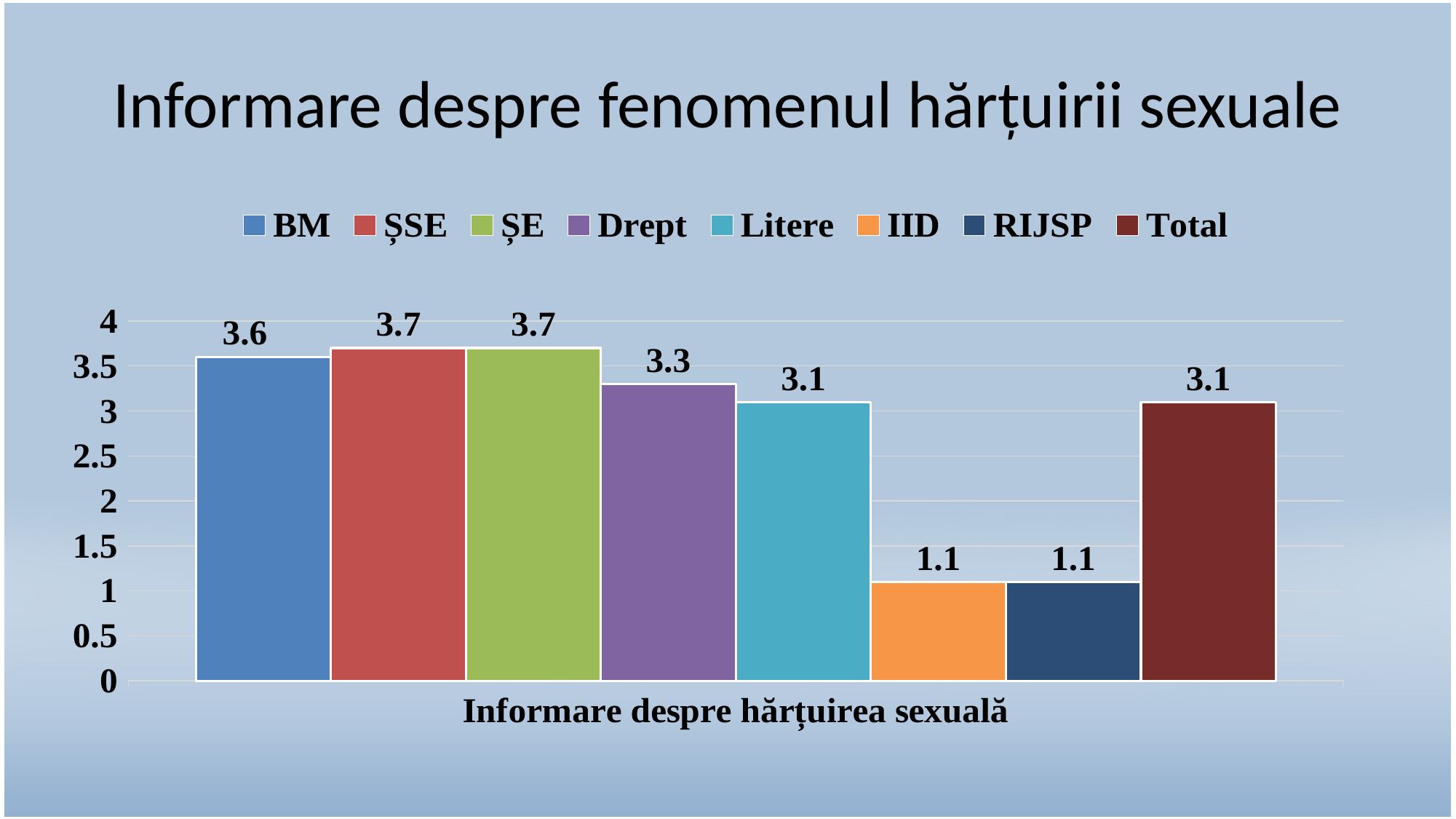
What is the value for Total? 3.1 What kind of chart is shown on the slide? bar chart What is the title of the slide? Informare despre fenomenul hărțuirii sexuale What is the value for BM? 3.6 What is the value for Litere? 3.1 What is the value for Drept? 3.3 What is the value for IID? 1.1 Which series has the lowest value, BM or RIJSP? RIJSP What is the difference between the values for ȘSE and IID? 2.6 Is the value for RIJSP greater or less than 2? less How many series does the legend list? 8 Which is larger, the value for BM or the value for Drept? BM